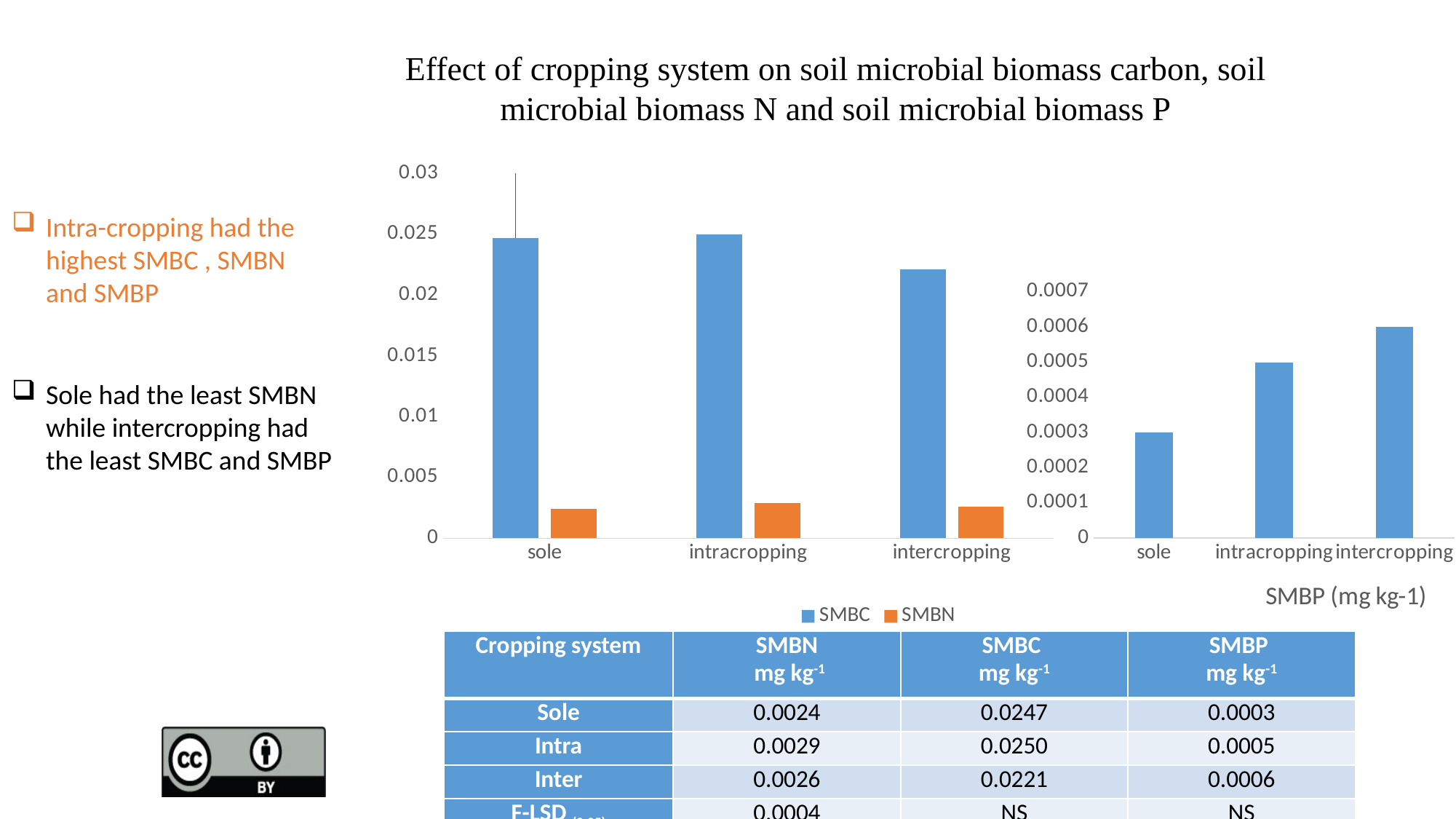
In the left chart, which cropping system has the highest SMBC bar? intracropping In the left chart, which cropping system has the lowest SMBC bar? intercropping How many cropping systems are shown on the x axis of the right chart? 3 What kind of chart is the left chart? bar chart In the left chart, which is larger for intracropping, the SMBC bar or the SMBN bar? SMBC In the right chart (SMBP), what is the value for sole? 0.0003 In the left chart, is the SMBN value for sole greater or less than 0.005? less In the right chart (SMBP), do the values rise or fall from sole to intercropping? rise In the right chart (SMBP), which cropping system has the highest value? intercropping In the right chart (SMBP), what is the value for intercropping? 0.0006 How many series does the legend of the left chart list? 2 In the left chart, is the SMBC value for intercropping greater or less than 0.02? greater